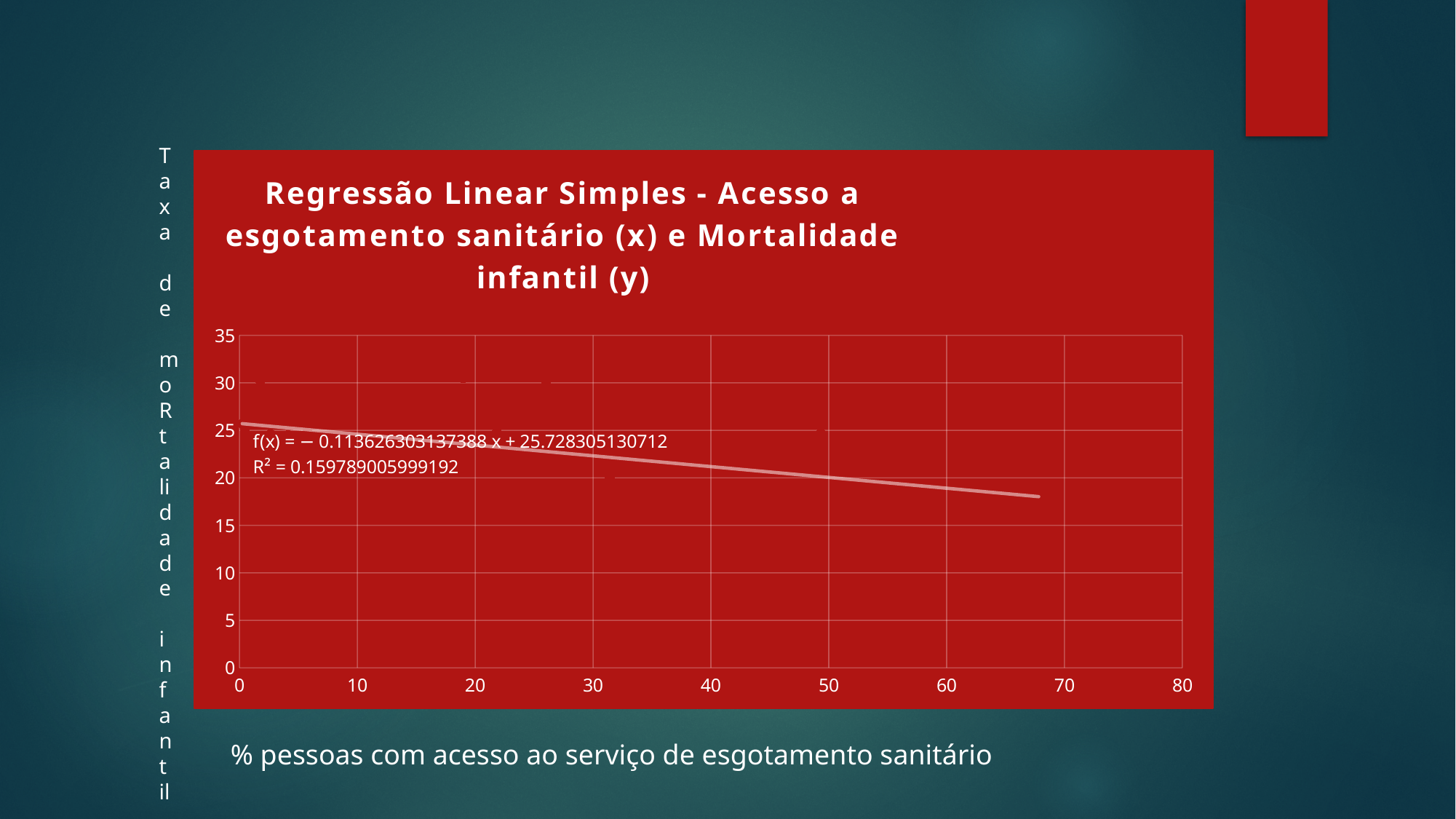
What is the title of the chart? Regressão Linear Simples - Acesso a esgotamento sanitário (x) e Mortalidade infantil (y) What is the maximum value shown on the y axis? 35 What is the slope of the trendline shown in the equation on the chart? − 0.113626303137388 Does the trendline rise or fall as the x value increases? fall What is the intercept of the trendline shown in the equation on the chart? 25.728305130712 Is the trendline's value at its right end (around x = 70) greater or less than 20? less What is the maximum value shown on the x axis? 80 Is the R² value greater or less than 0.5? less What kind of chart is shown on the slide? scatter chart What is the R² value printed on the chart? R² = 0.159789005999192 What is the trendline equation printed on the chart? f(x) = − 0.113626303137388 x + 25.728305130712 What is the label of the x axis written below the chart? % pessoas com acesso ao serviço de esgotamento sanitário